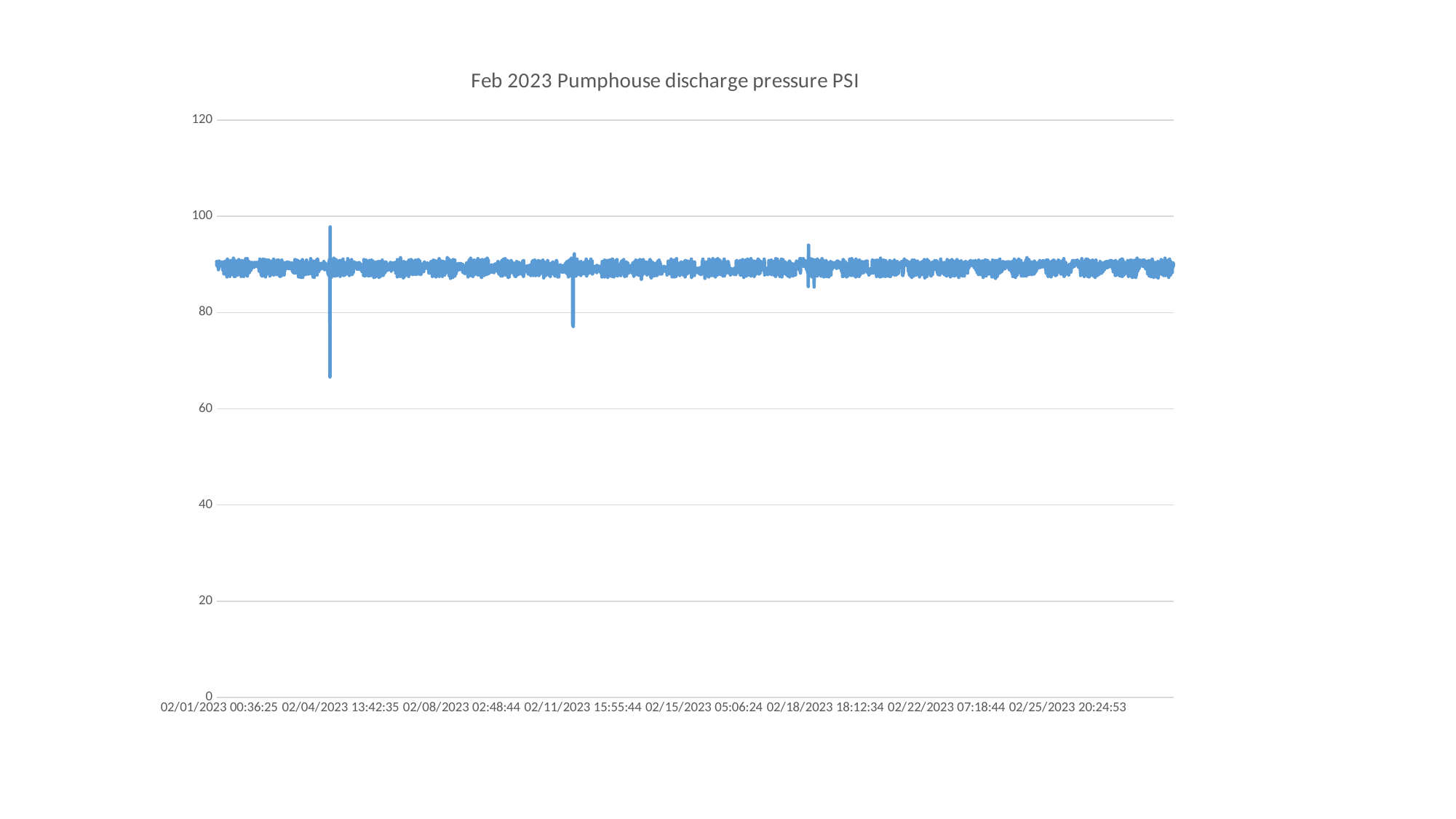
Is the lowest dip in the line (near 02/04/2023) greater or less than 80? less Is the lowest dip in the line (near 02/04/2023) greater or less than 60? greater Is the highest spike in the line greater or less than 100? less Does the discharge pressure generally rise, fall, or stay flat across the month? stay flat What kind of chart is shown on the slide? line chart How many timestamp labels are shown along the x axis? 8 What is the highest value shown on the y axis? 120 What is the title of the chart? Feb 2023 Pumphouse discharge pressure PSI How many data series (lines) are plotted on the chart? 1